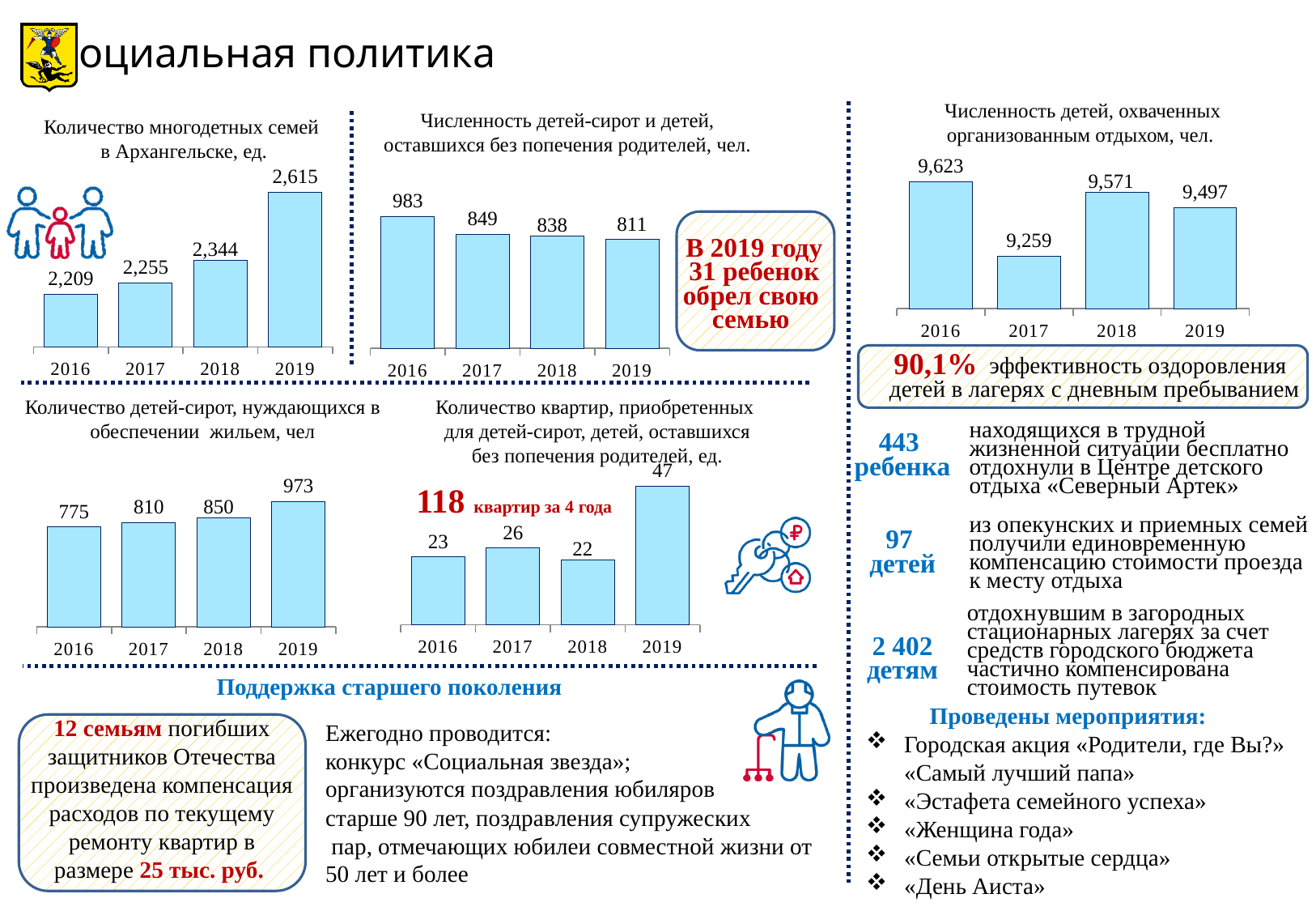
What type of chart is 'Количество многодетных семей в Архангельске, ед.'? bar chart In the chart 'Численность детей-сирот и детей, оставшихся без попечения родителей, чел.', what is the difference between the 2016 and 2019 values? 172 In the chart 'Количество многодетных семей в Архангельске, ед.', do the values rise or fall from 2016 to 2019? rise In the chart 'Количество квартир, приобретенных для детей-сирот, детей, оставшихся без попечения родителей, ед.', what is the total of the four years' values? 118 In the chart 'Количество многодетных семей в Архангельске, ед.', what is the value for 2019? 2,615 In the chart 'Количество квартир, приобретенных для детей-сирот, детей, оставшихся без попечения родителей, ед.', which is larger, the value for 2017 or 2018? 2017 In the chart 'Численность детей-сирот и детей, оставшихся без попечения родителей, чел.', which year has the highest value? 2016 In the chart 'Численность детей, охваченных организованным отдыхом, чел.', which year has the lowest value? 2017 In the chart 'Количество детей-сирот, нуждающихся в обеспечении жильем, чел', how many years are shown on the x axis? 4 In the chart 'Количество детей-сирот, нуждающихся в обеспечении жильем, чел', what is the value for 2018? 850 In the chart 'Количество квартир, приобретенных для детей-сирот, детей, оставшихся без попечения родителей, ед.', which year has the highest value? 2019 In the chart 'Численность детей, охваченных организованным отдыхом, чел.', what is the value for 2017? 9,259